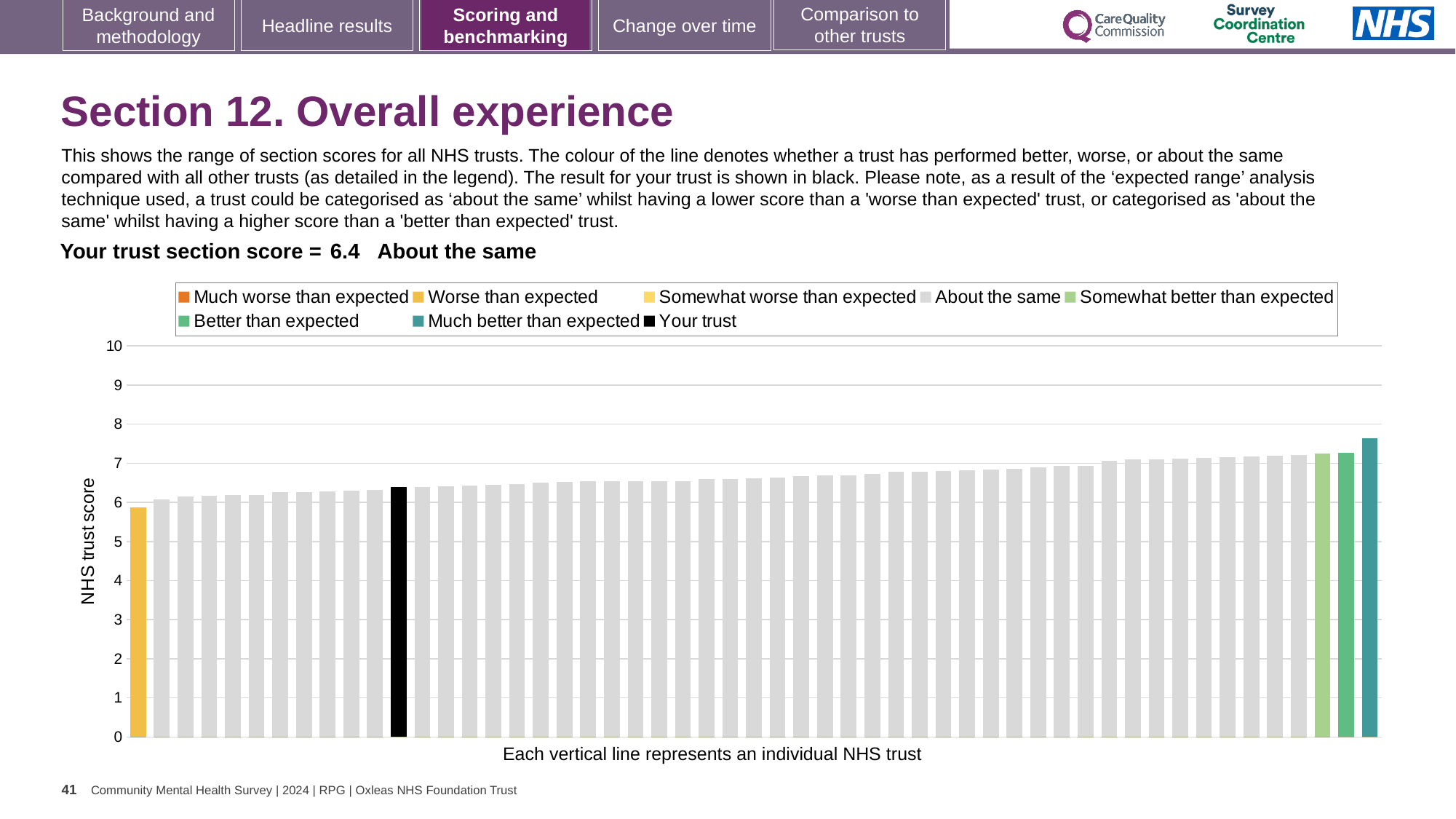
Is the value of the tallest bar (the rightmost teal bar) greater or less than 7? greater Do the bar values rise or fall from left to right along the x axis? rise How many entries does the chart legend list? 8 Which legend category does the tallest bar on the chart belong to? Much better than expected Which is larger: the value for your trust (black bar) or the value of the rightmost teal bar? the rightmost teal bar What kind of chart is shown on the slide? bar chart What is the label on the y axis of the chart? NHS trust score Which legend category does the shortest bar on the chart belong to? Worse than expected Is the value of the leftmost (yellow) bar greater or less than 7? less Is the value for your trust (the black bar) greater or less than 6? greater What colour is the bar representing your trust? black What is the section score for your trust shown on the slide? 6.4